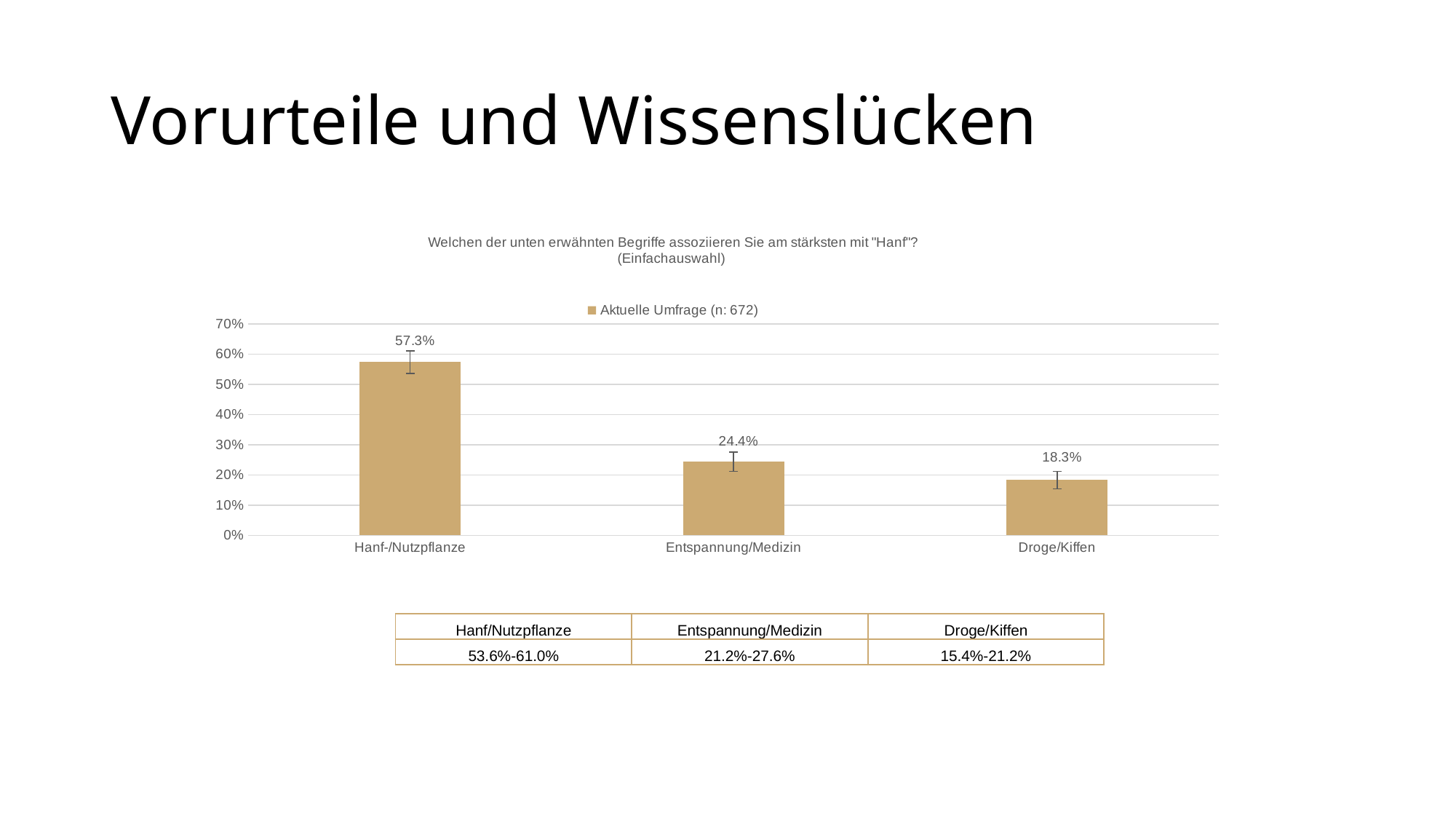
What is the difference between the values for Entspannung/Medizin and Droge/Kiffen? 6.1% What is the value for Hanf-/Nutzpflanze? 57.3% How many categories are shown on the x axis? 3 Which category has the highest value? Hanf-/Nutzpflanze What is the difference between the values for Hanf-/Nutzpflanze and Entspannung/Medizin? 32.9% What is the value for Droge/Kiffen? 18.3% Which is larger, the value for Entspannung/Medizin or the value for Droge/Kiffen? Entspannung/Medizin Which category has the lowest value? Droge/Kiffen What is the value for Entspannung/Medizin? 24.4% What kind of chart is shown on the slide? bar chart Is the value for Hanf-/Nutzpflanze greater or less than 50%? greater What series does the legend list? Aktuelle Umfrage (n: 672)